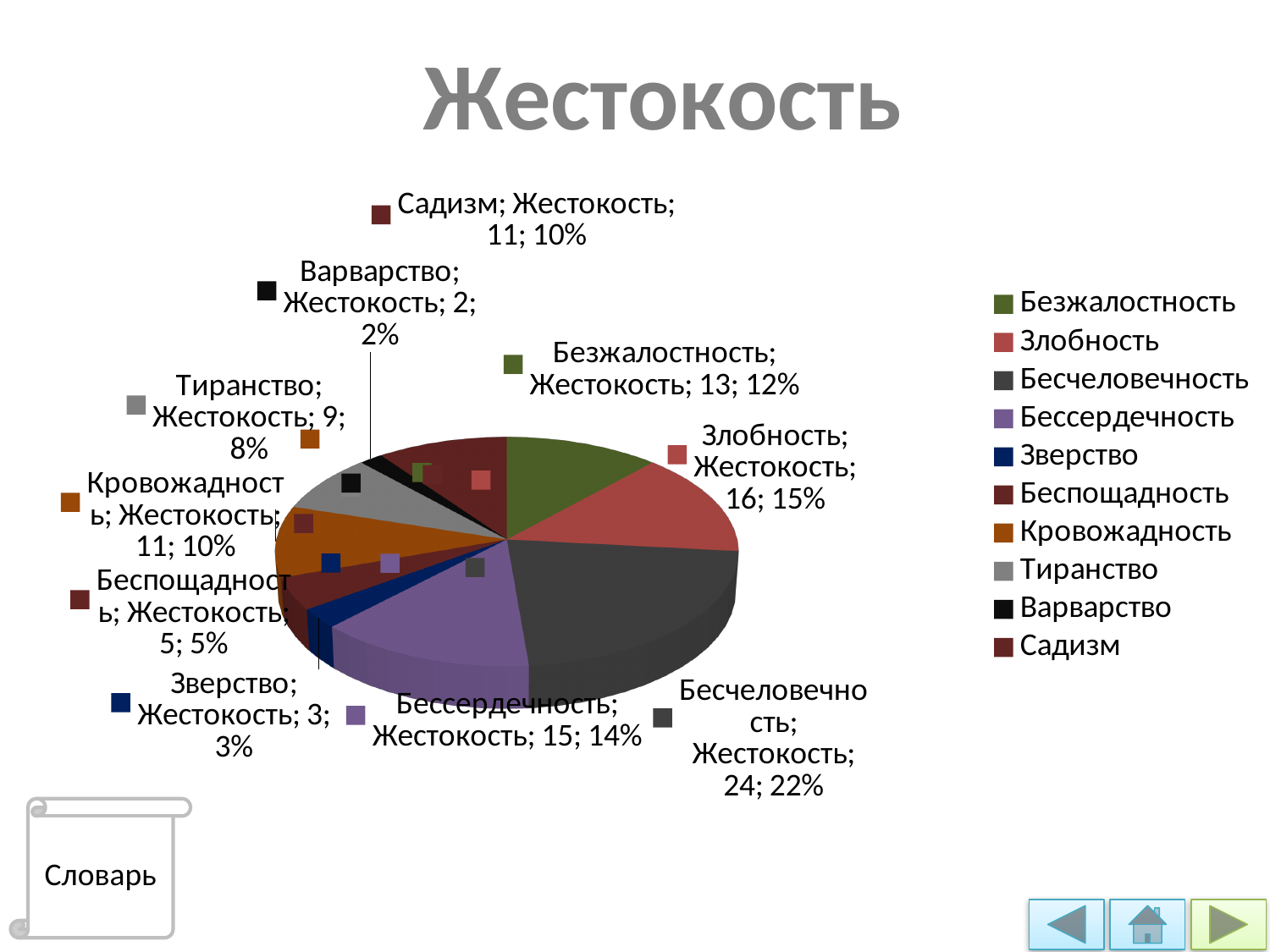
What is the difference between the values for Бесчеловечность and Беспощадность? 19 What kind of chart is shown on the slide? pie chart What is the value for Бесчеловечность? 24 Which is larger, the value for Безжалостность or the value for Кровожадность? Безжалостность What is the value for Тиранство? 9 What percentage share does Злобность have? 15% What percentage share does Зверство have? 3% Which category has the smallest slice? Варварство What is the title of the slide? Жестокость How many categories does the pie chart have? 10 What is the difference between the values for Злобность and Бессердечность? 1 Which category has the largest slice? Бесчеловечность